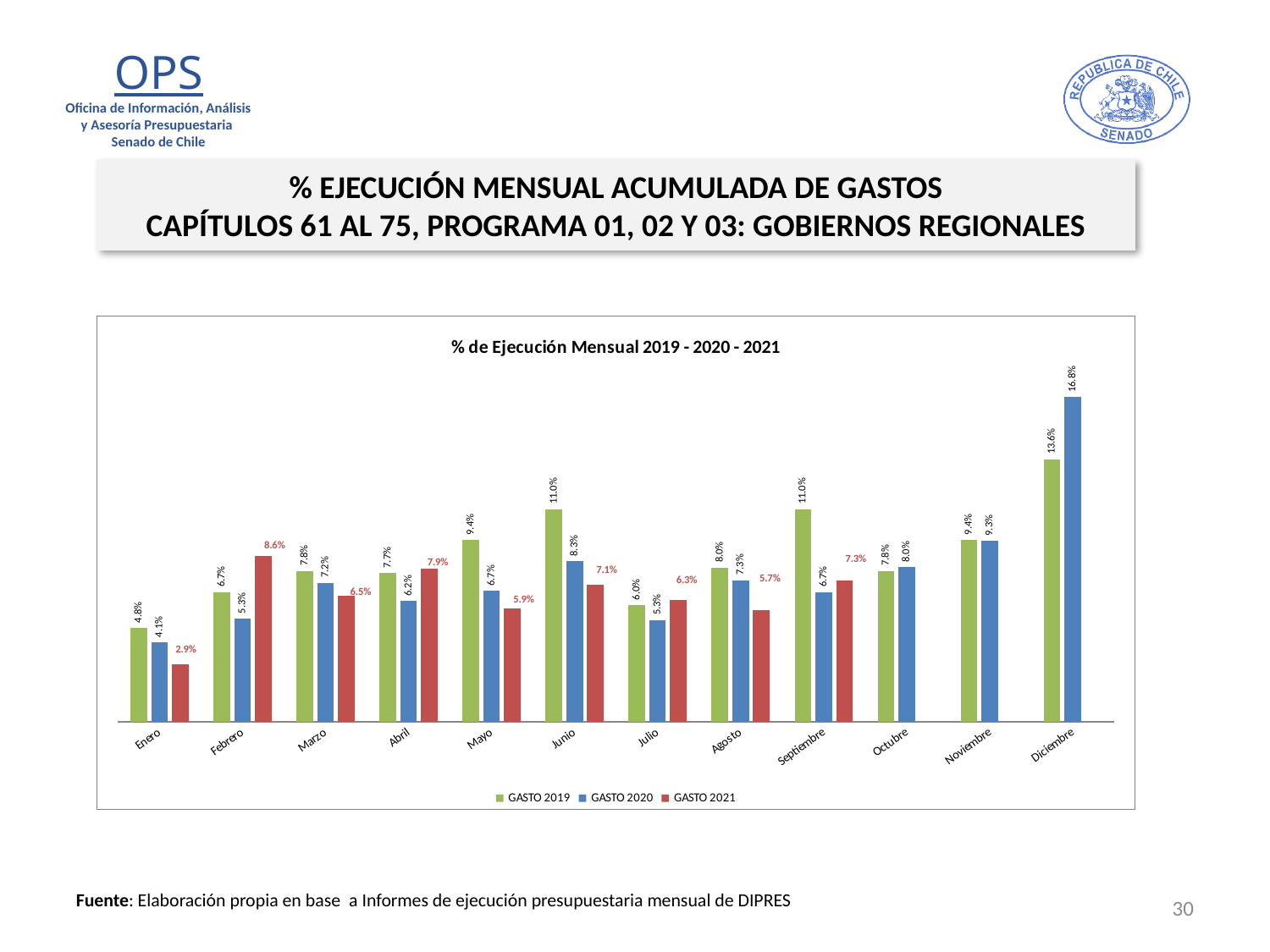
What is the difference between GASTO 2020 and GASTO 2019 in Diciembre? 3.2 percentage points In which month is GASTO 2021 lowest? Enero In Junio, which is larger: GASTO 2019 or GASTO 2020? GASTO 2019 In which month is GASTO 2021 highest? Febrero What type of chart is shown on the slide? Bar chart What is the value for GASTO 2021 in Enero? 2.9% How many months are shown on the x axis? 12 What is the value for GASTO 2020 in Diciembre? 16.8% In which month is GASTO 2020 highest? Diciembre How many series does the legend list? 3 What is the value for GASTO 2019 in Septiembre? 11.0% What is the title of the chart? % de Ejecución Mensual 2019 - 2020 - 2021